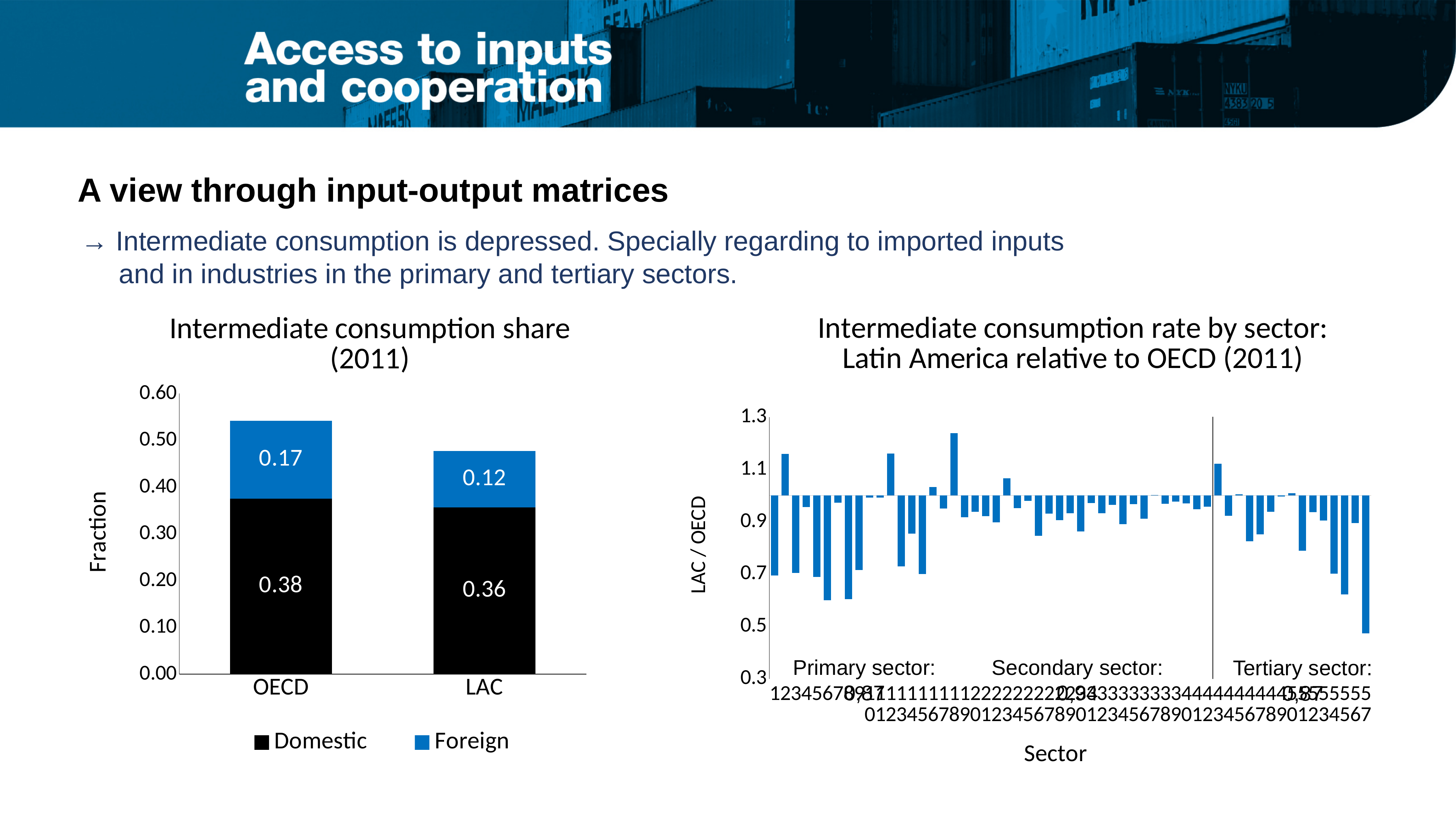
In the 'Intermediate consumption share (2011)' chart, which category has the larger Domestic value, OECD or LAC? OECD In the 'Intermediate consumption share (2011)' chart, how many categories are shown on the x axis? 2 In the 'Intermediate consumption share (2011)' chart, what is the total of the stacked bar for LAC? 0.48 In the 'Intermediate consumption share (2011)' chart, what is the total of the stacked bar for OECD? 0.55 In the 'Intermediate consumption share (2011)' chart, what is the Foreign value for LAC? 0.12 In the 'Intermediate consumption rate by sector' chart, what is the label of the y axis? LAC / OECD What kind of chart is the 'Intermediate consumption rate by sector: Latin America relative to OECD (2011)' chart? Bar chart In the 'Intermediate consumption share (2011)' chart, what is the Foreign value for OECD? 0.17 In the 'Intermediate consumption share (2011)' chart, what is the Domestic value for LAC? 0.36 In the 'Intermediate consumption share (2011)' chart, what is the Domestic value for OECD? 0.38 In the 'Intermediate consumption share (2011)' chart, how many series does the legend list? 2 In the 'Intermediate consumption share (2011)' chart, what is the difference between the Foreign values for OECD and LAC? 0.05